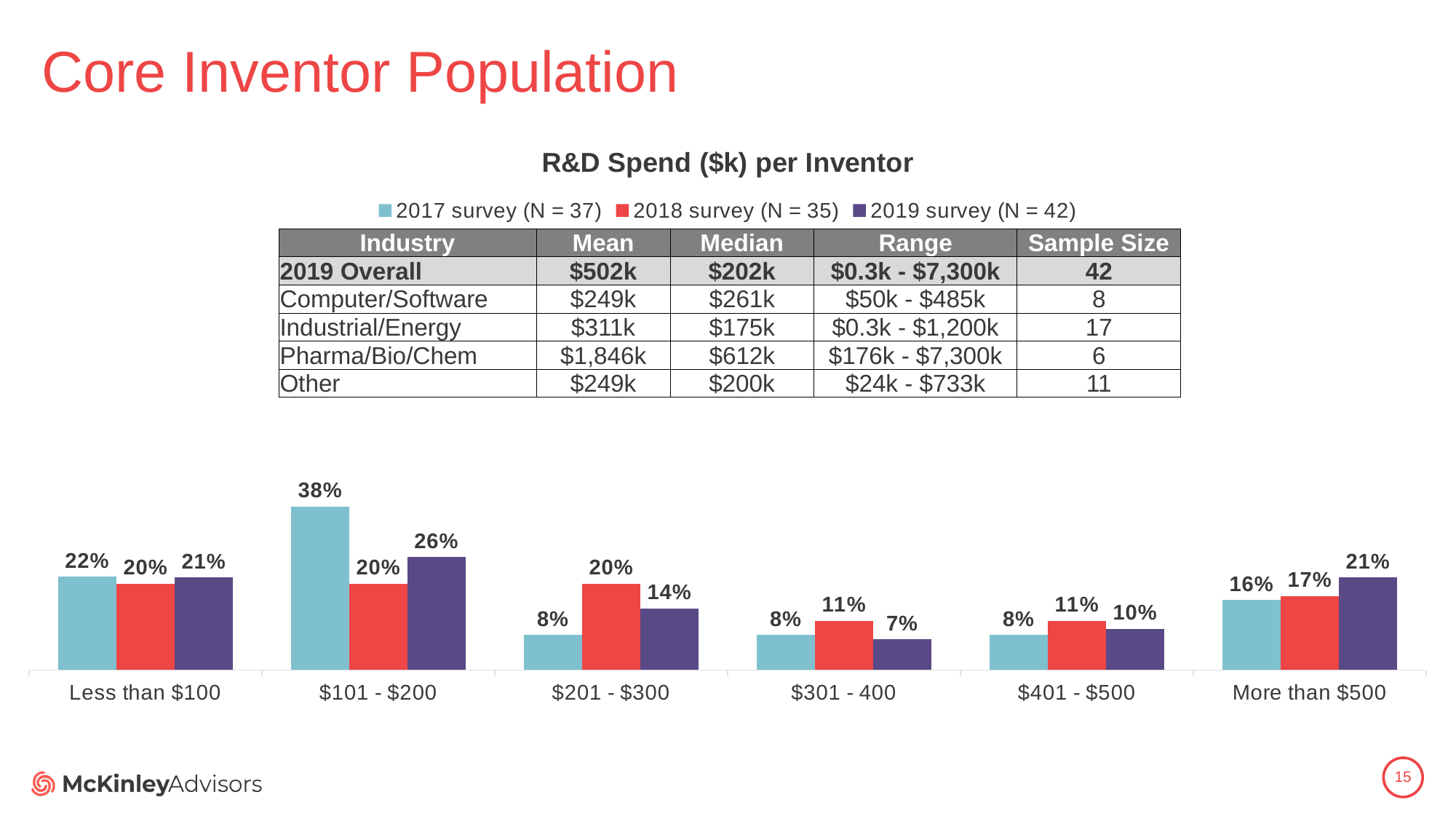
What is the title of the chart? R&D Spend ($k) per Inventor Which category has the highest value for the 2017 survey? $101 - $200 What is the value for the 2019 survey in the More than $500 category? 21% What is the difference between the 2017 survey and 2019 survey values in the $101 - $200 category? 12% Which category has the lowest value for the 2019 survey? $301 - 400 What is the value for the 2018 survey in the $201 - $300 category? 20% How many series does the chart legend list? 3 What is the sample size (N) for the 2019 survey shown in the legend? 42 In the $201 - $300 category, which is larger: the 2018 survey value or the 2019 survey value? 2018 survey What is the value for the 2017 survey in the $101 - $200 category? 38% What kind of chart is shown on the slide? Bar chart How many categories are shown on the x axis of the chart? 6